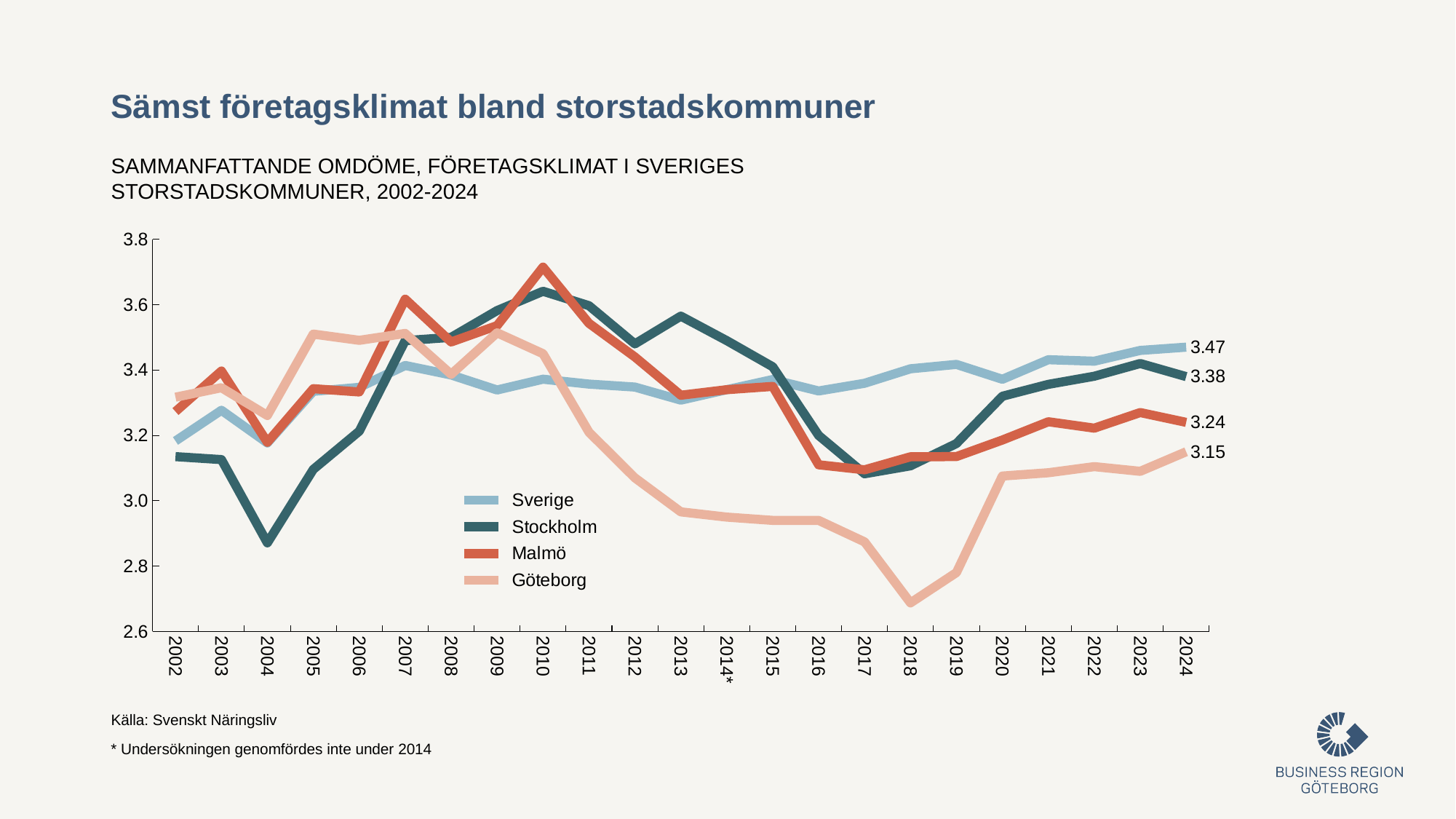
Is the value for Malmö in 2010 greater or less than 3.6? greater What is the value for Göteborg in 2024? 3.15 How many series does the legend list? 4 What type of chart is shown on the slide? Line chart What is the value for Stockholm in 2024? 3.38 What is the value for Sverige in 2024? 3.47 Which series has the highest value in 2024? Sverige What is the difference between the 2024 values for Sverige and Göteborg? 0.32 Is the value for Göteborg in 2018 greater or less than 2.8? less What is the value for Malmö in 2024? 3.24 Which series has the lowest value in 2024? Göteborg Which is larger in 2024, the value for Stockholm or the value for Malmö? Stockholm